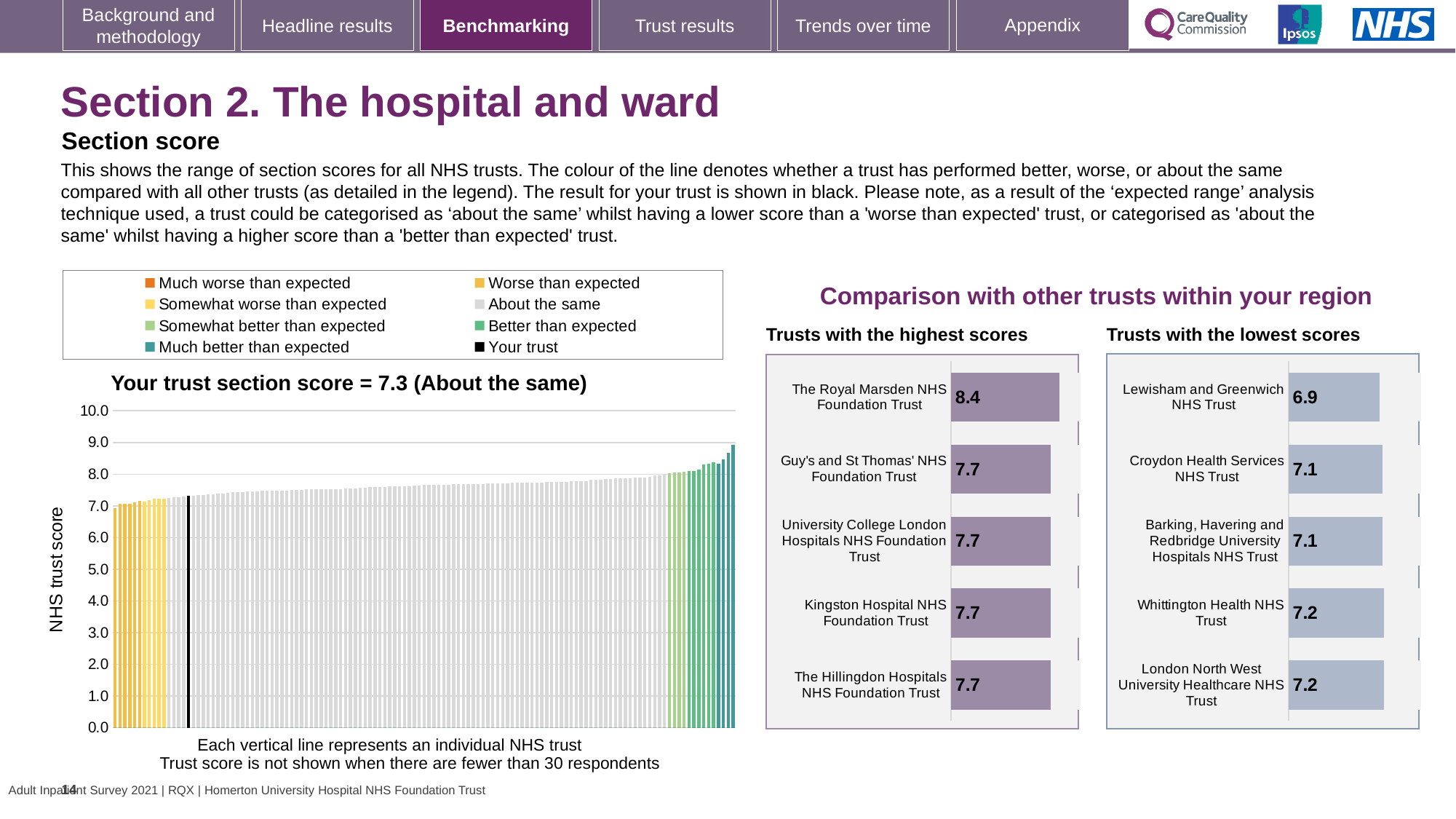
In the 'Your trust section score' chart on the left, do the trust scores rise or fall from left to right along the x axis? Rise In the 'Trusts with the highest scores' chart, which trust has the highest score? The Royal Marsden NHS Foundation Trust In the 'Trusts with the lowest scores' chart, what is the difference between the scores of London North West University Healthcare NHS Trust and Lewisham and Greenwich NHS Trust? 0.3 How many entries does the legend above the 'Your trust section score' chart list? 8 In the 'Trusts with the lowest scores' chart, which has the higher score: Croydon Health Services NHS Trust or Whittington Health NHS Trust? Whittington Health NHS Trust In the 'Trusts with the lowest scores' chart, which trust has the lowest score? Lewisham and Greenwich NHS Trust What kind of chart is the 'Your trust section score' chart on the left? Bar chart In the 'Trusts with the highest scores' chart, what is the score for The Royal Marsden NHS Foundation Trust? 8.4 In the 'Your trust section score' chart on the left, what is the section score for your trust? 7.3 In the 'Trusts with the highest scores' chart, what is the difference between the scores of The Royal Marsden NHS Foundation Trust and Kingston Hospital NHS Foundation Trust? 0.7 In the 'Trusts with the highest scores' chart, how many trusts are listed? 5 In the 'Trusts with the lowest scores' chart, what is the score for Lewisham and Greenwich NHS Trust? 6.9